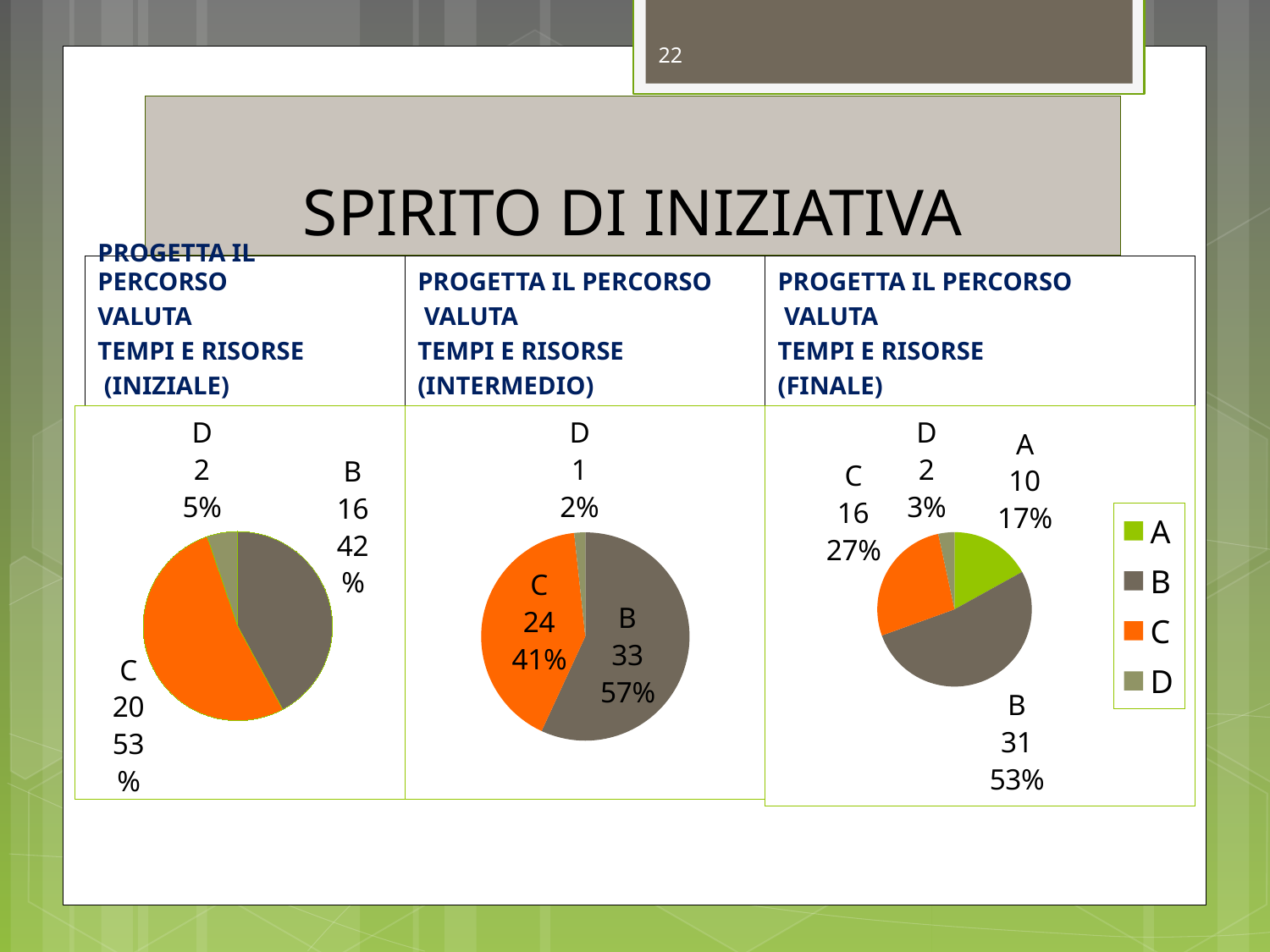
In the INTERMEDIO pie chart, what is the difference between the values for B and C? 9 In the FINALE pie chart, how many categories are plotted? 4 In the INIZIALE pie chart, which category has the smallest slice? D In the INTERMEDIO pie chart, which category has the largest slice? B In the FINALE pie chart, what is the value for category A? 10 In the FINALE pie chart, which is larger, the value for C or the value for A? C In the INIZIALE pie chart, what percentage share does category B have? 42% How many entries does the legend next to the FINALE pie chart list? 4 In the INTERMEDIO pie chart, what is the value for category B? 33 In the INIZIALE pie chart, what is the value for category C? 20 In the INTERMEDIO pie chart, what percentage share does category D have? 2% What type of chart is used in the INIZIALE panel? Pie chart